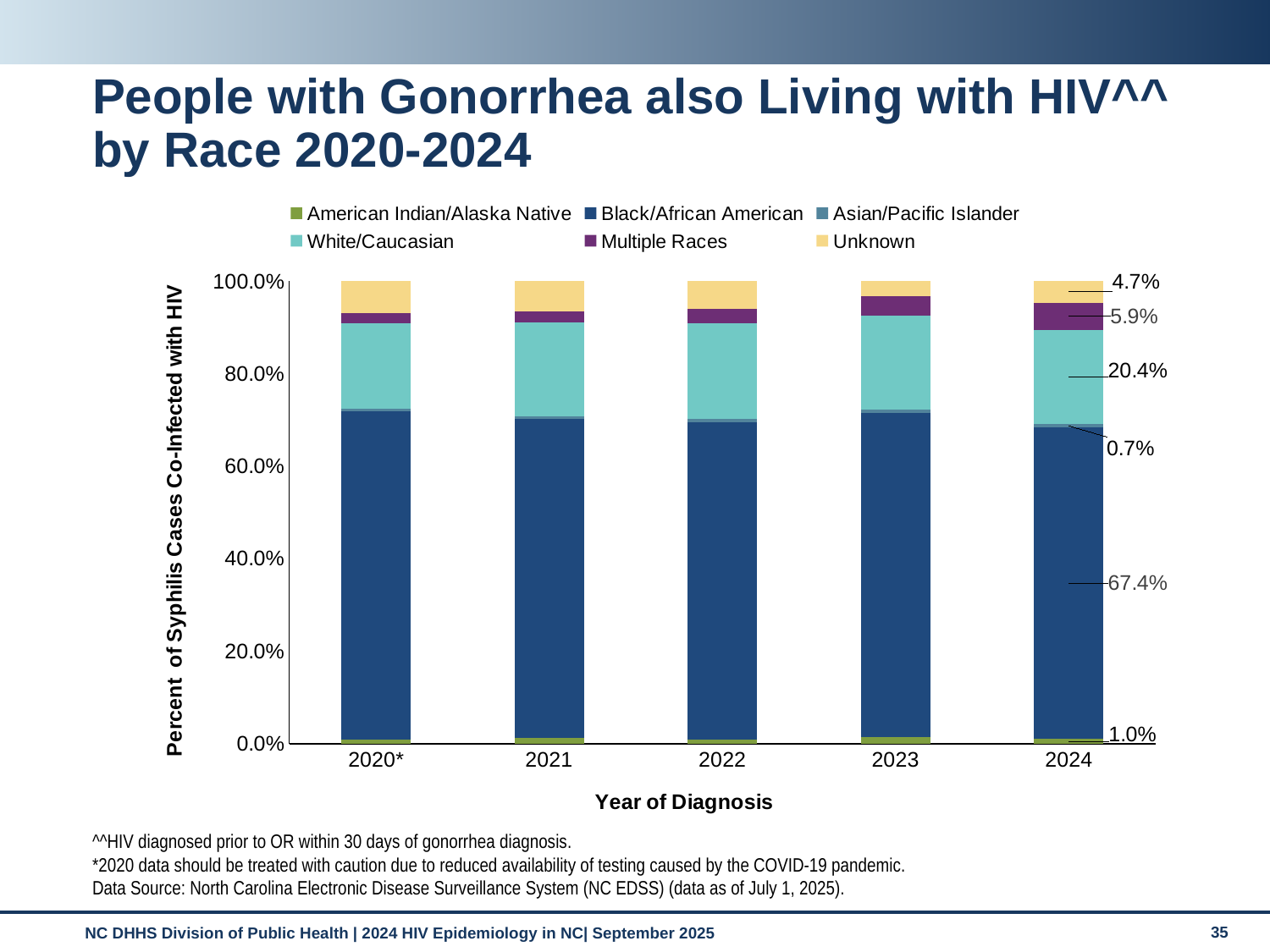
What is the American Indian/Alaska Native share shown for 2024? 1.0% Which race group has the largest share in the 2024 bar? Black/African American What kind of chart is shown on the slide? Stacked bar chart In 2024, how many percentage points larger is the Black/African American share than the White/Caucasian share? 47.0 percentage points Which race group has the smallest share in the 2024 bar? Asian/Pacific Islander What percentage of the 2024 bar is White/Caucasian? 20.4% What is the Asian/Pacific Islander share shown for 2024? 0.7% What is the Multiple Races share shown for 2024? 5.9% How many series does the legend list? 6 How many years are shown on the x axis? 5 What percentage of the 2024 bar is Black/African American? 67.4% What is the Unknown share shown for 2024? 4.7%